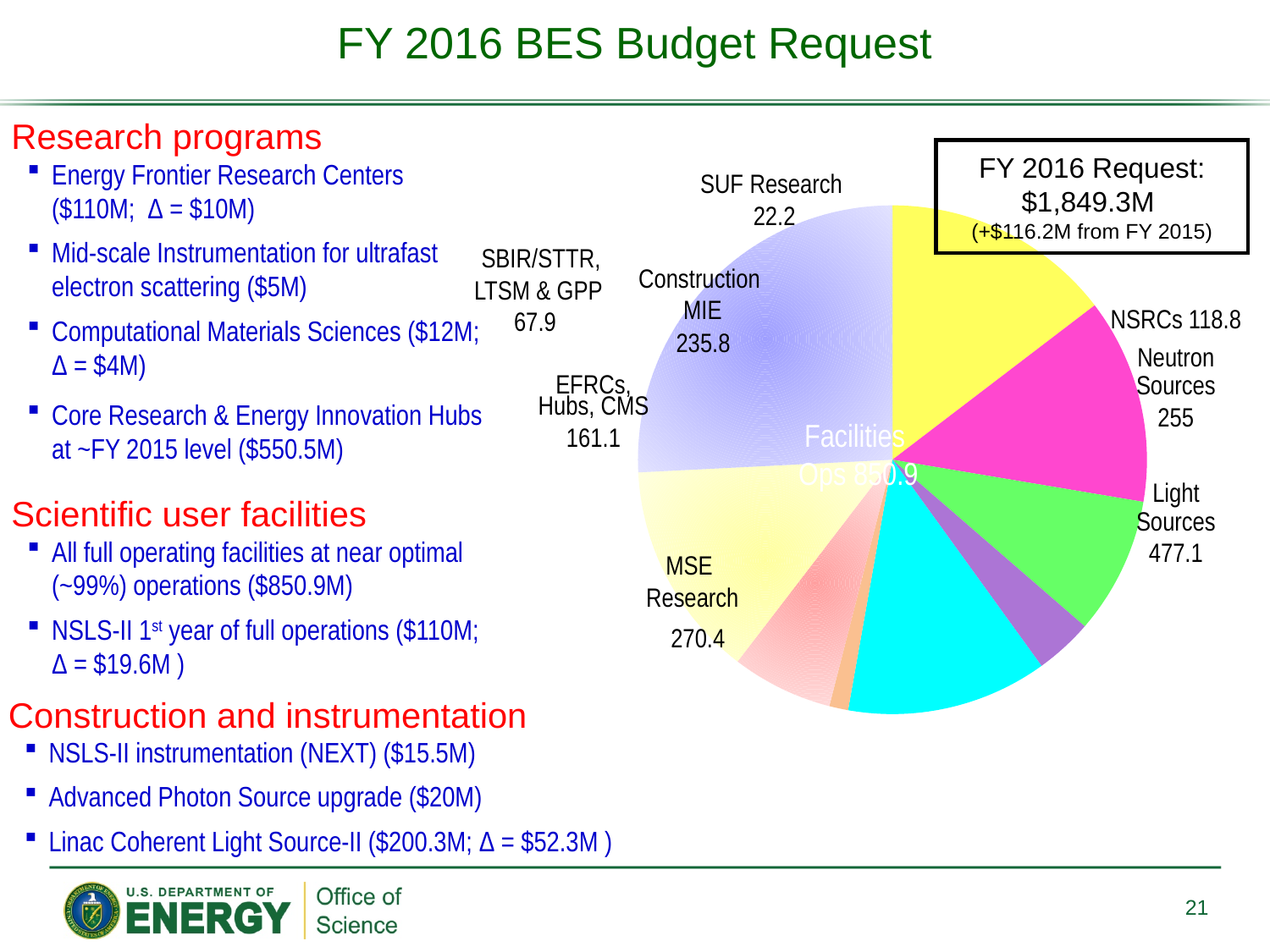
What is the value shown for Light Sources in the pie chart? 477.1 What is the value shown for Neutron Sources in the pie chart? 255 Which labeled slice has the smallest value in the pie chart? SUF Research What is the value shown for SBIR/STTR, LTSM & GPP in the pie chart? 67.9 What is the value shown for NSRCs in the pie chart? 118.8 What is the value shown for MSE Research in the pie chart? 270.4 What total FY 2016 request amount is shown in the box next to the pie chart? $1,849.3M What is the difference between the Light Sources value and the Neutron Sources value? 222.1 Which labeled slice has the largest value in the pie chart? Light Sources What type of chart is shown on the slide? pie chart Which is larger, MSE Research or EFRCs, Hubs, CMS? MSE Research What is the value shown for Construction MIE in the pie chart? 235.8